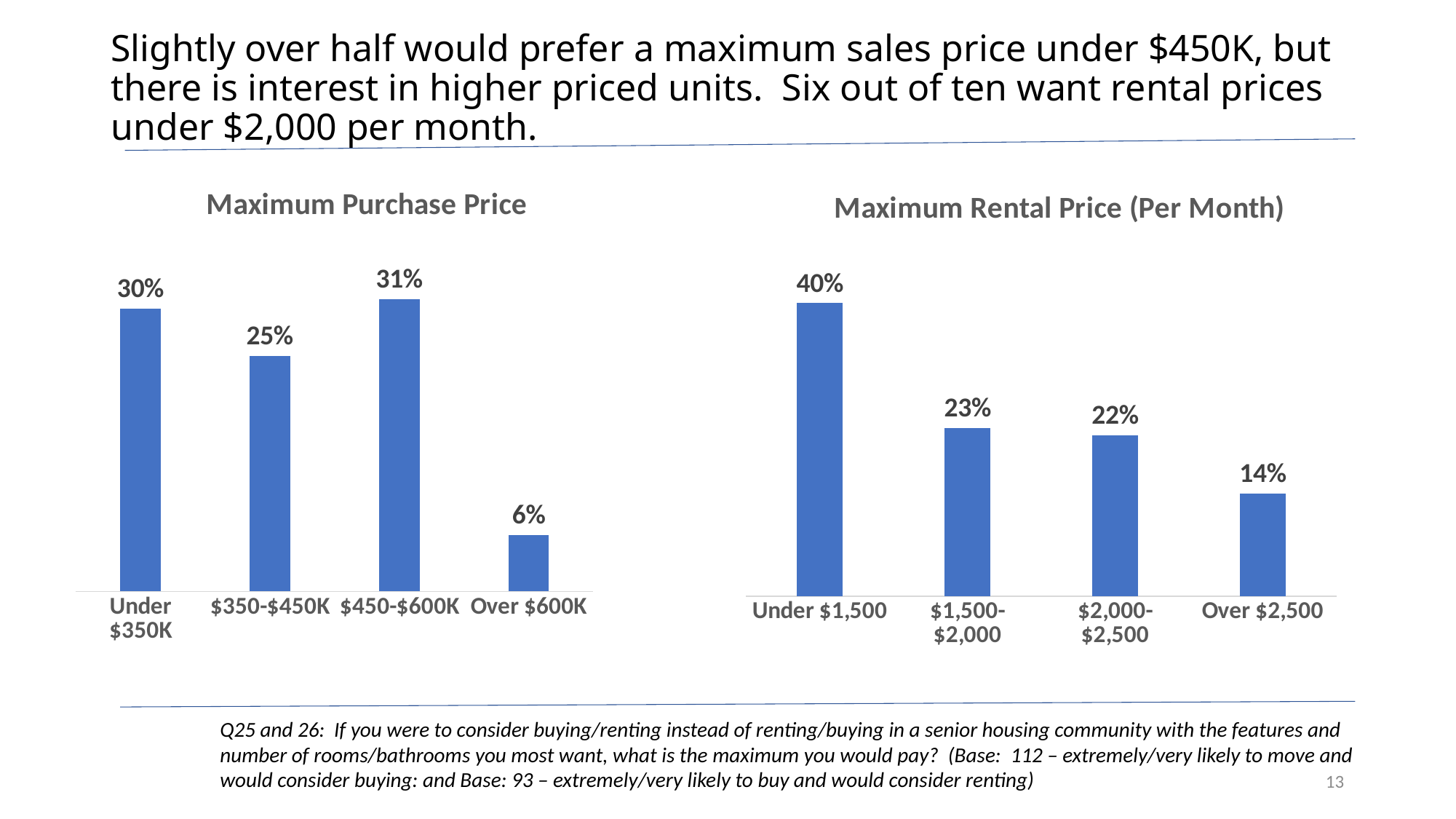
How many categories are shown in the Maximum Rental Price (Per Month) chart? 4 What is the title of the chart on the right side of the slide? Maximum Rental Price (Per Month) In the Maximum Rental Price (Per Month) chart, which category has the highest value? Under $1,500 In the Maximum Rental Price (Per Month) chart, what percentage chose Under $1,500? 40% In the Maximum Purchase Price chart, which category has the lowest value? Over $600K In the Maximum Purchase Price chart, which is larger: the value for Under $350K or the value for $350-$450K? Under $350K In the Maximum Purchase Price chart, which category has the highest value? $450-$600K What kind of chart is the Maximum Purchase Price chart? Bar chart In the Maximum Rental Price (Per Month) chart, what is the difference between the values for Under $1,500 and $1,500-$2,000? 17% In the Maximum Purchase Price chart, what is the difference between the values for Under $350K and Over $600K? 24% In the Maximum Rental Price (Per Month) chart, what percentage chose Over $2,500? 14% In the Maximum Purchase Price chart, what percentage chose $350-$450K? 25%